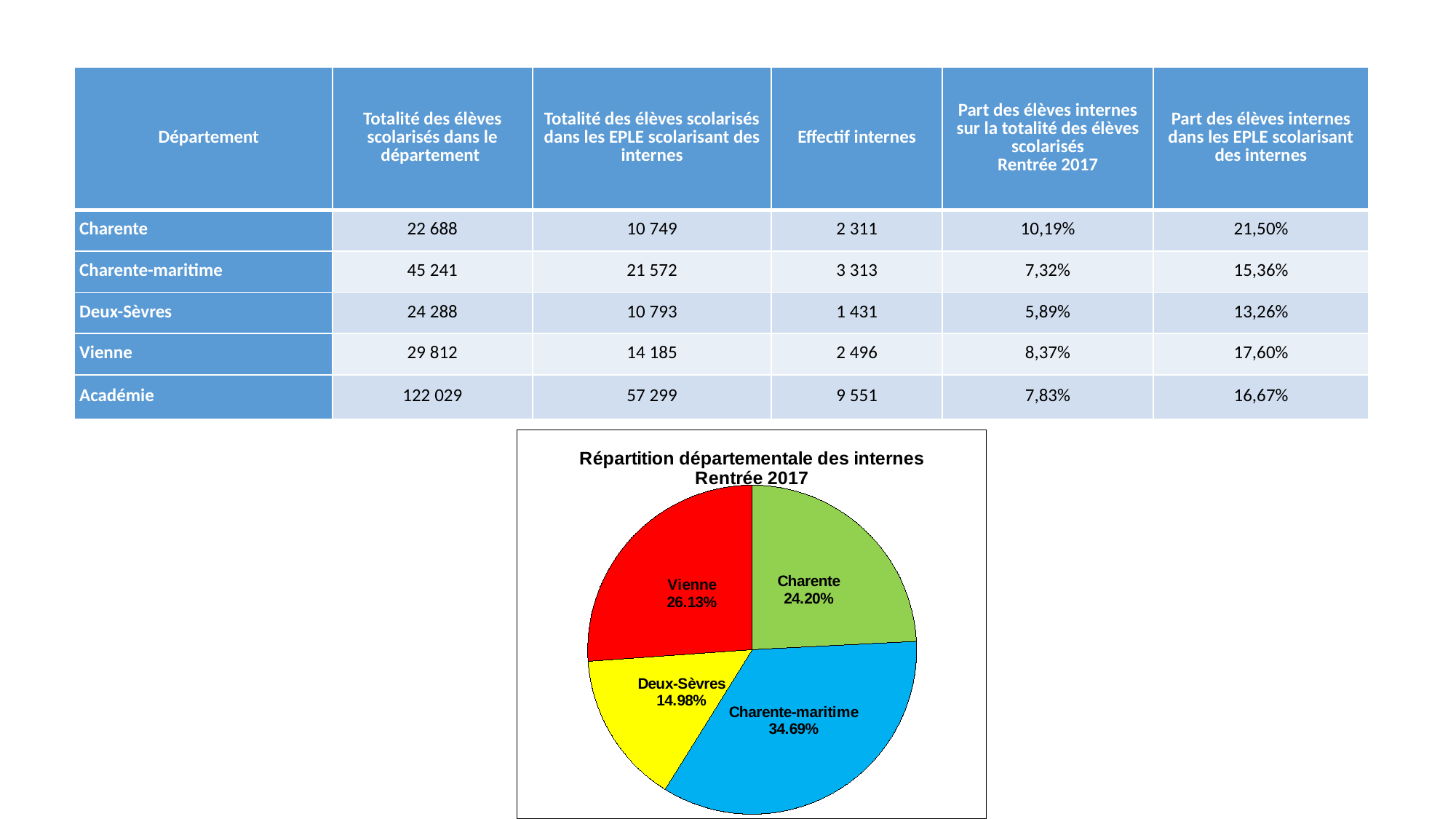
What is the title of the pie chart? Répartition départementale des internes Rentrée 2017 What is the difference in percentage points between the Charente-maritime slice and the Deux-Sèvres slice? 19.71 What share of the pie does Deux-Sèvres represent? 14.98% How many slices does the pie chart have? 4 Which slice is larger, Vienne or Charente? Vienne What share of the pie does Charente represent? 24.20% Which département has the largest slice of the pie? Charente-maritime What kind of chart is shown on the slide? pie chart What share of the pie does Charente-maritime represent? 34.69% Which département has the smallest slice of the pie? Deux-Sèvres What colour is the Charente-maritime slice in the pie chart? blue